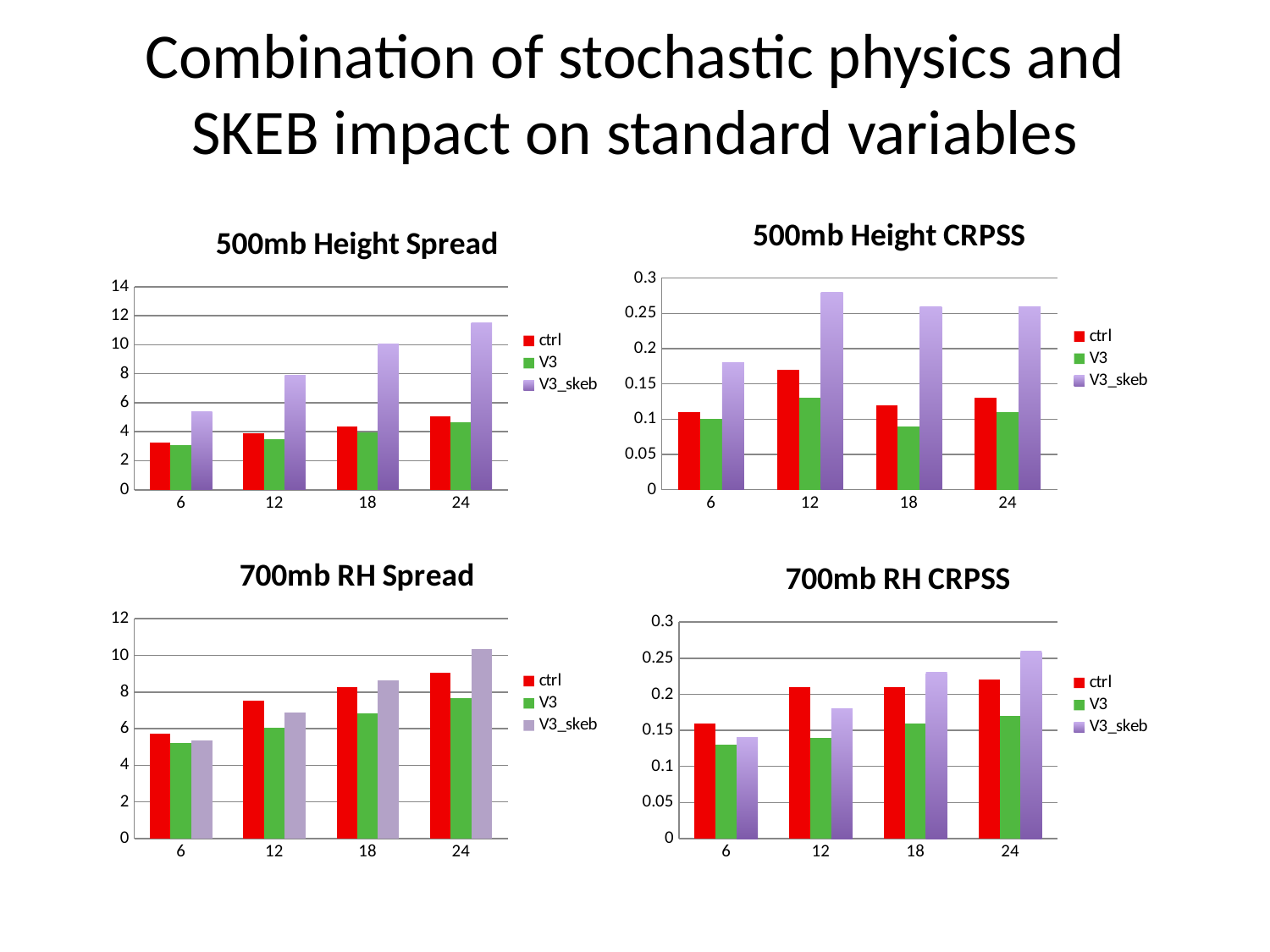
In the 500mb Height Spread chart, does the V3_skeb series rise or fall from 6 to 24? rise In the 500mb Height Spread chart, is the value for V3_skeb at 24 greater or less than 10? greater How many x-axis categories does the 700mb RH Spread chart show? 4 In the 700mb RH CRPSS chart, is the value for V3 at 6 greater or less than 0.15? less In the 500mb Height Spread chart, which series has the tallest bar at 24? V3_skeb In the 700mb RH CRPSS chart, which series has the tallest bar at 24? V3_skeb In the 500mb Height CRPSS chart, which series has the lowest bar at 18? V3 In the 700mb RH Spread chart, which is larger at 12: ctrl or V3_skeb? ctrl In the 700mb RH Spread chart, is the value for ctrl at 24 greater or less than 8? greater What kind of chart is the 700mb RH CRPSS chart? bar chart How many series does the legend of the 500mb Height CRPSS chart list? 3